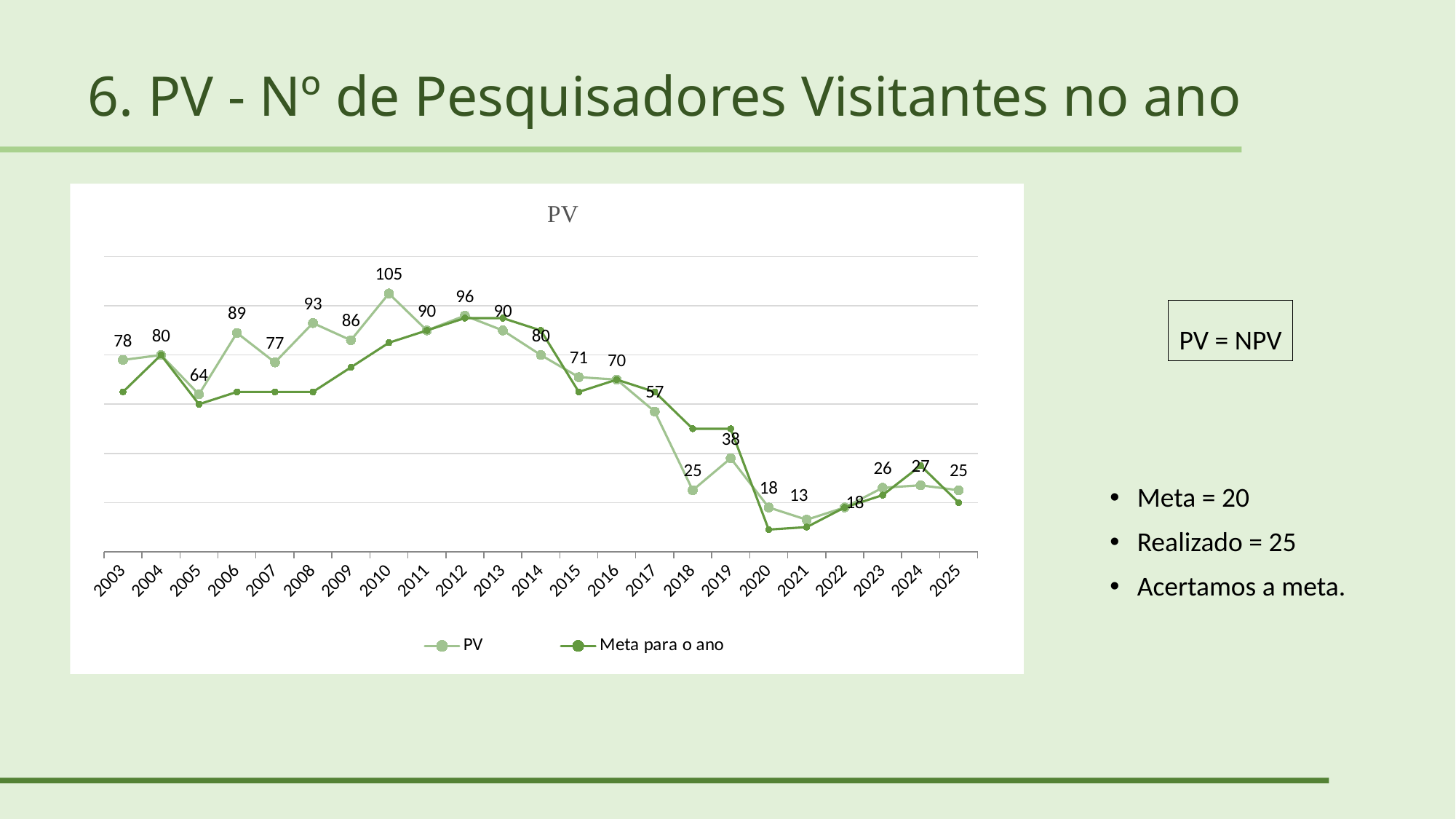
Does the PV series generally rise or fall from 2013 to 2021? fall What are the names of the two series in the legend of the PV chart? PV and Meta para o ano In which year is the PV series at its highest? 2010 What is the PV value for 2010? 105 How many years are shown on the x axis of the PV chart? 23 What type of chart is shown on the slide? line chart What is the PV value for 2021? 13 What is the difference between the PV values for 2012 and 2018? 71 Which year has a higher PV value, 2006 or 2007? 2006 In which year is the PV series at its lowest? 2021 How many series does the legend of the PV chart list? 2 What is the PV value for 2025? 25